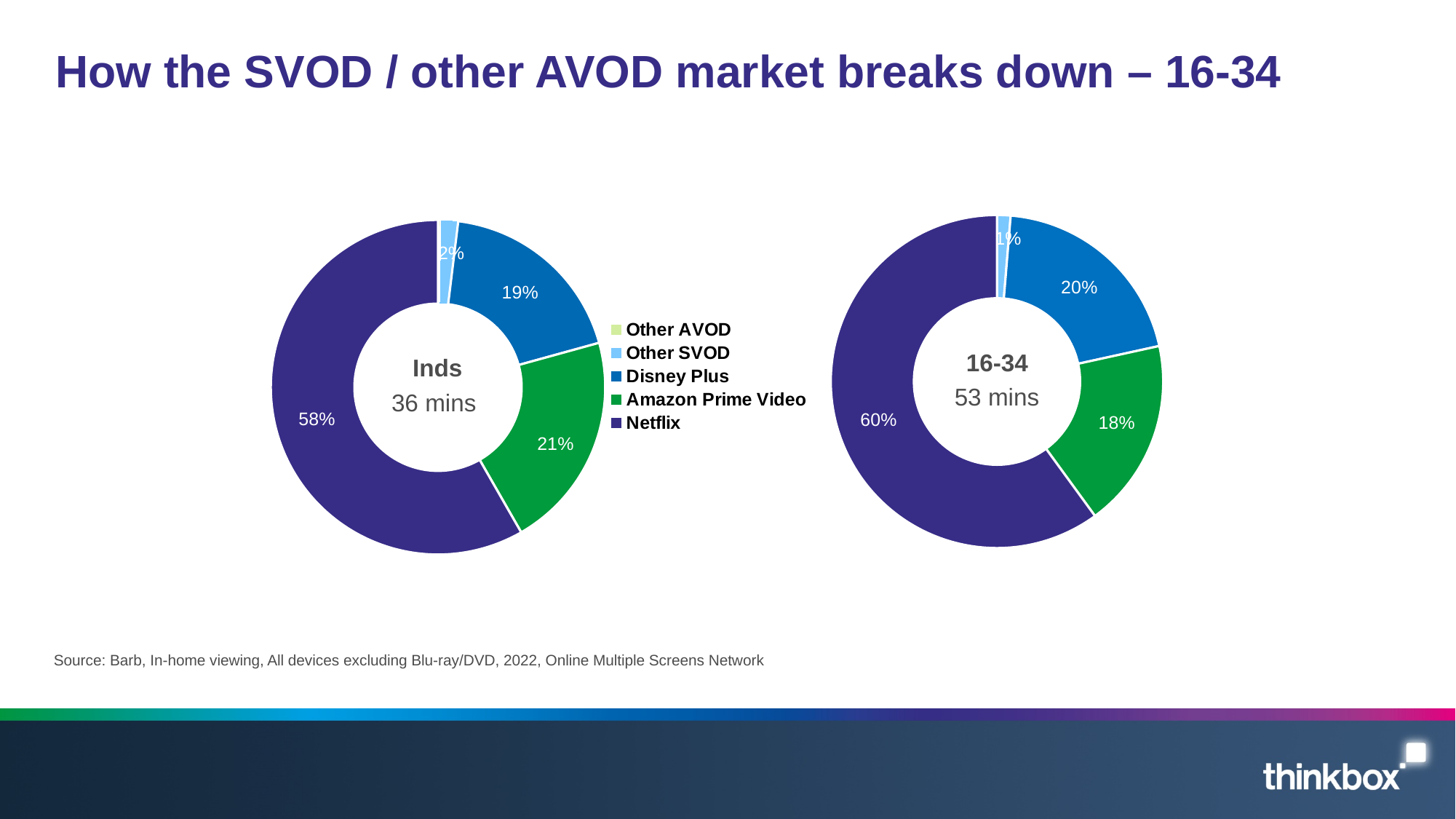
In the Inds chart, which is larger: Amazon Prime Video or Disney Plus? Amazon Prime Video What is the total viewing time shown in the centre of the 16-34 chart? 53 mins In the 16-34 chart, which service has the largest share? Netflix What kind of chart is used on this slide? Donut (pie) chart What is the difference between Netflix's share in the 16-34 chart and in the Inds chart? 2 percentage points In the 16-34 chart, what share does Disney Plus have? 20% In the Inds chart, what share does Other SVOD have? 2% In the Inds chart, what share does Netflix have? 58% In the 16-34 chart, what share does Amazon Prime Video have? 18% In the 16-34 chart, which is larger: Disney Plus or Amazon Prime Video? Disney Plus In the Inds chart, which labelled slice is the smallest? Other SVOD How many entries does the legend list? 5